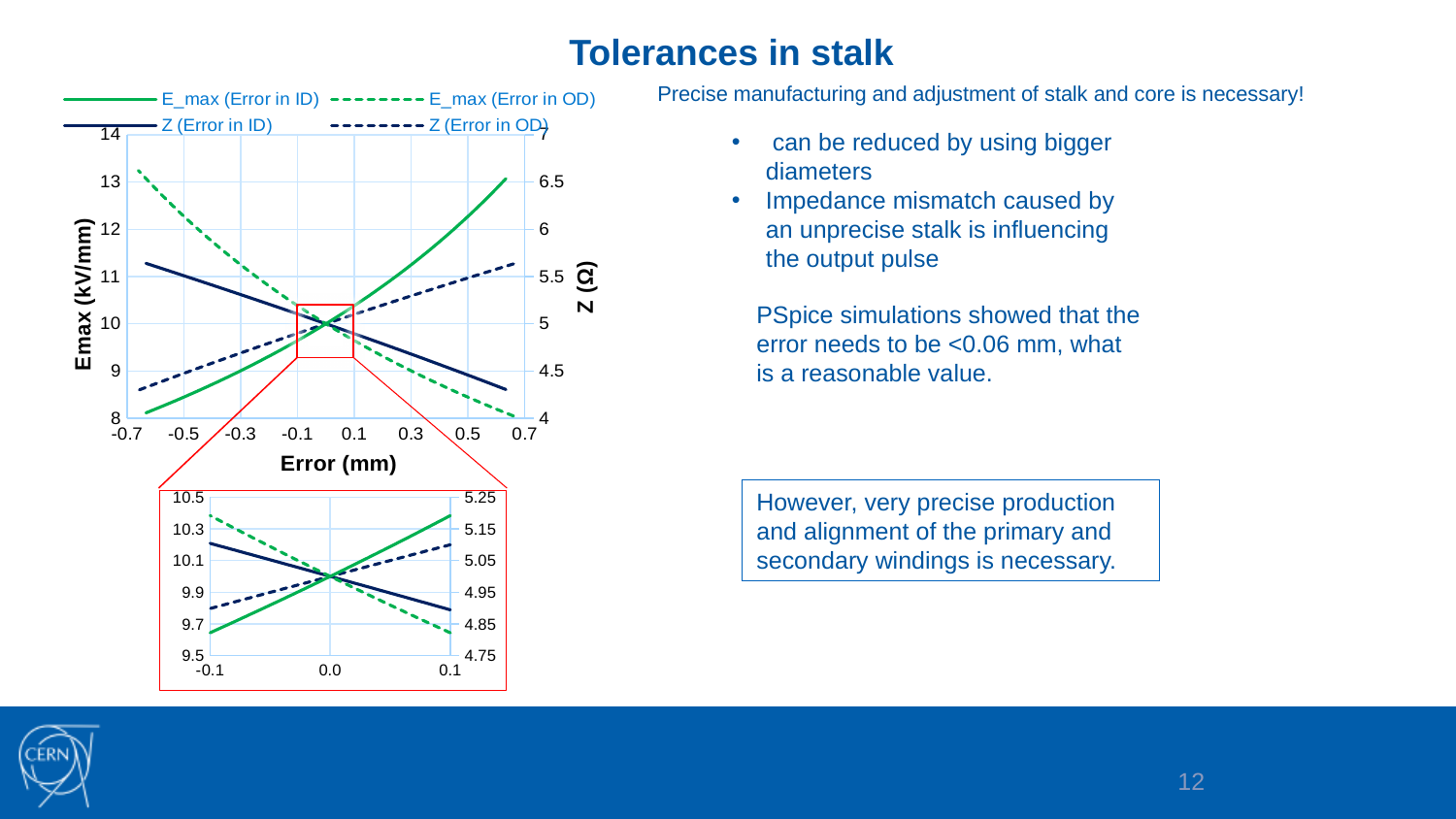
What range of Error (mm) does the zoomed inset chart below the main chart cover? -0.1 to 0.1 How many series does the legend of the main chart list? 4 What is the title of the x axis of the main chart? Error (mm) What kind of chart is the main chart on the left of the slide? line chart In the main chart, is the E_max (Error in OD) value at an error of -0.5 mm greater or less than 11 kV/mm? greater In the main chart, is the Z (Error in ID) value at an error of -0.7 mm greater or less than 5 Ω? greater In the main chart, is the E_max (Error in ID) value at an error of -0.5 mm greater or less than 9 kV/mm? less In the main chart, does the Z (Error in OD) line rise or fall as Error (mm) increases? rise In the main chart, does the Z (Error in ID) line rise or fall as Error (mm) increases? fall In the main chart, does the E_max (Error in OD) line rise or fall as Error (mm) increases? fall In the main chart, at an error of 0.5 mm, which is higher: E_max (Error in ID) or E_max (Error in OD)? E_max (Error in ID)